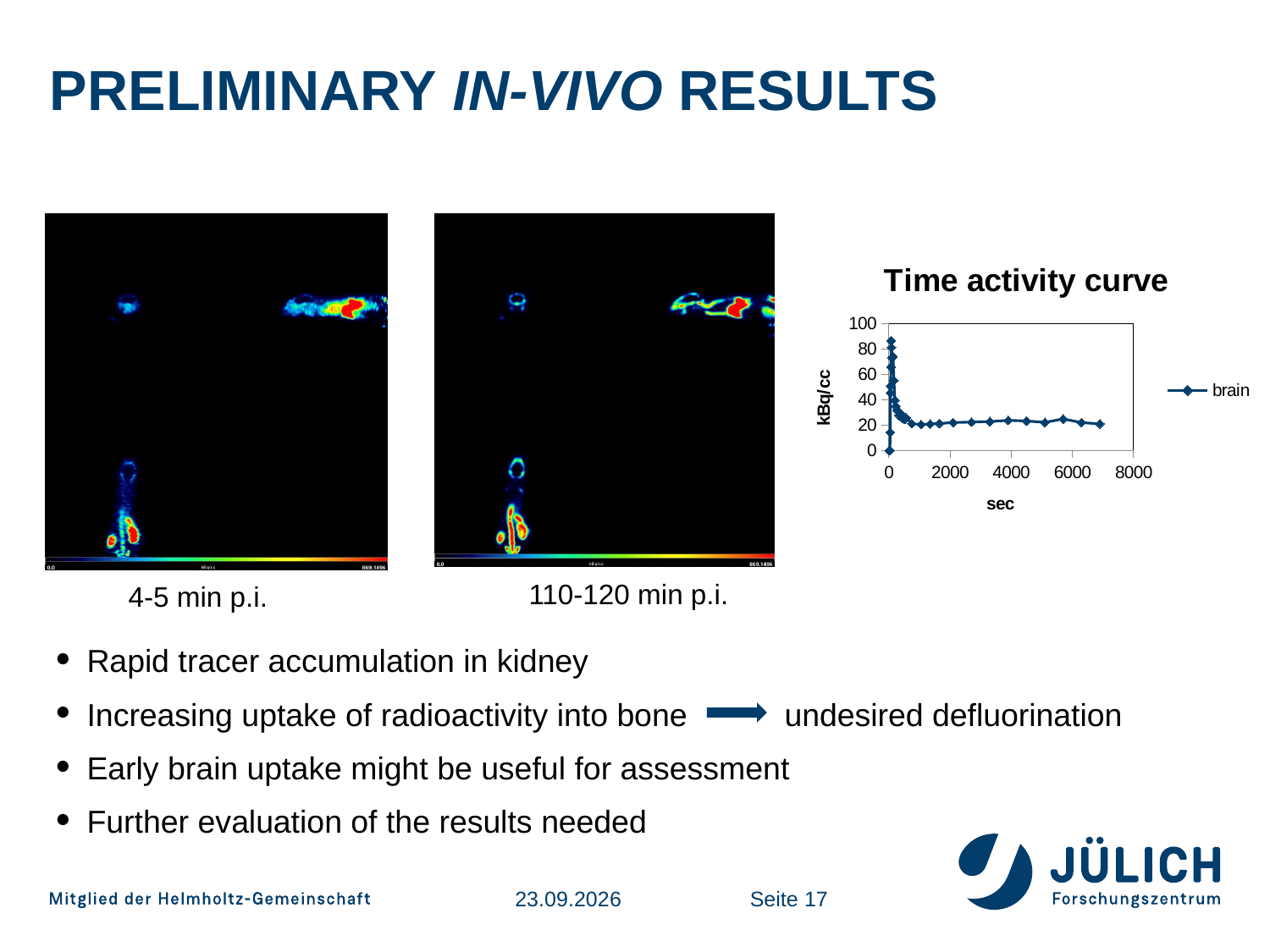
In the "Time activity curve" chart, is the brain value at around 6000 sec greater or less than 60 kBq/cc? less What is the maximum value shown on the y axis of the "Time activity curve" chart? 100 In the "Time activity curve" chart, is the brain value at the last plotted point (around 7000 sec) greater or less than 40 kBq/cc? less What is the title of the chart on the slide? Time activity curve What kind of chart is the "Time activity curve"? line chart What is the name of the series shown in the legend of the "Time activity curve" chart? brain In the "Time activity curve" chart, do the brain values rise or fall along the x axis after the initial peak? fall In the "Time activity curve" chart, is the brain value higher near 0 sec or near 6000 sec? near 0 sec In the "Time activity curve" chart, is the brain value at around 4000 sec greater or less than 40 kBq/cc? less How many series does the legend of the "Time activity curve" chart list? 1